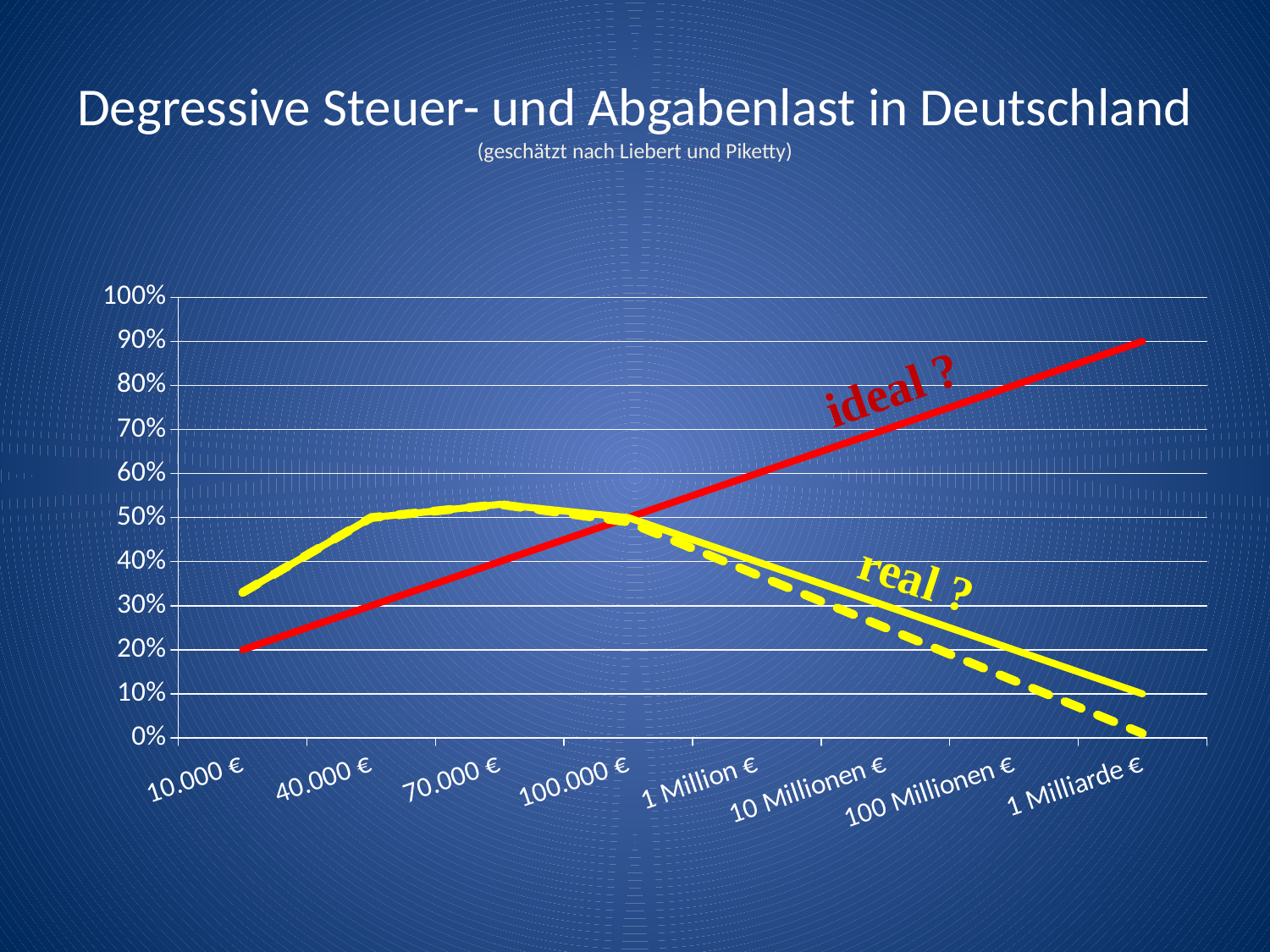
Does the solid yellow line rise or fall from 100.000 € to 1 Milliarde €? fall By how many percentage points does the red line increase from 10.000 € to 1 Milliarde €? 70 What is the value of the red line at 10.000 €? 20% Does the red line rise or fall from 10.000 € to 1 Milliarde €? rise What is the value of the red line at 1 Milliarde €? 90% Is the value of the solid yellow line at 10.000 € greater or less than 40%? less How many categories are shown on the x axis? 8 What label is written along the red line? ideal ? What kind of chart is shown on the slide? line chart At 1 Milliarde €, which line has the larger value, the red line or the solid yellow line? the red line What is the value of the solid yellow line at 1 Milliarde €? 10%